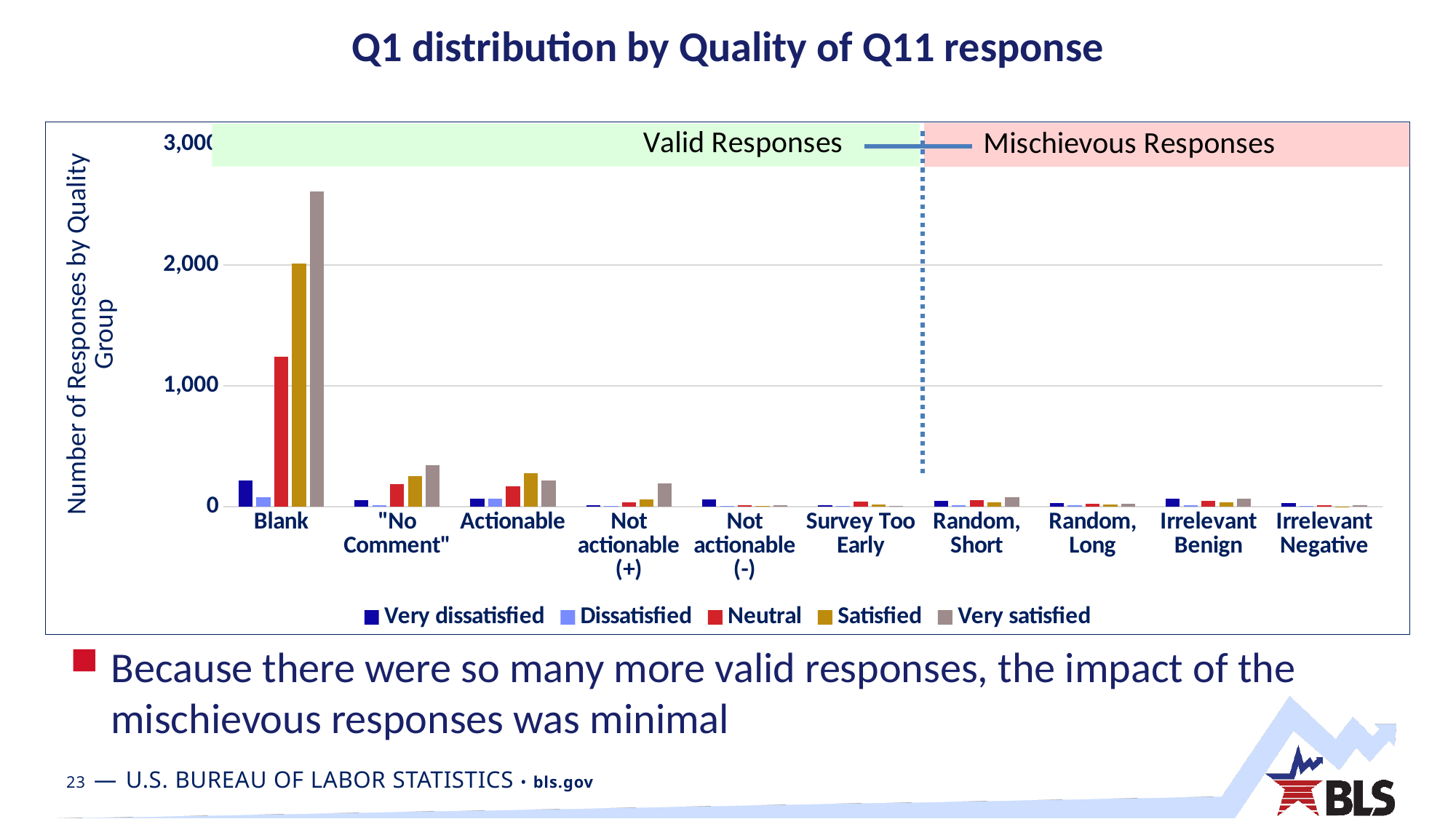
Is the Neutral value for Blank greater or less than 1,000? greater Which series has the highest value in the Blank category? Very satisfied What kind of chart is shown on the slide? bar chart Which category has the tallest bar in the chart? Blank Which two groups of responses are labelled by the shaded bands at the top of the chart? Valid Responses and Mischievous Responses How many categories are shown on the x axis? 10 Is the Very satisfied value for "No Comment" greater or less than 1,000? less In the Blank category, which is larger: the Very satisfied value or the Satisfied value? Very satisfied Which is larger: the Very satisfied value for Blank or the Very satisfied value for Actionable? Blank What is the title of the chart? Q1 distribution by Quality of Q11 response Is the Very satisfied value for Blank greater or less than 2,000? greater How many series does the legend list? 5